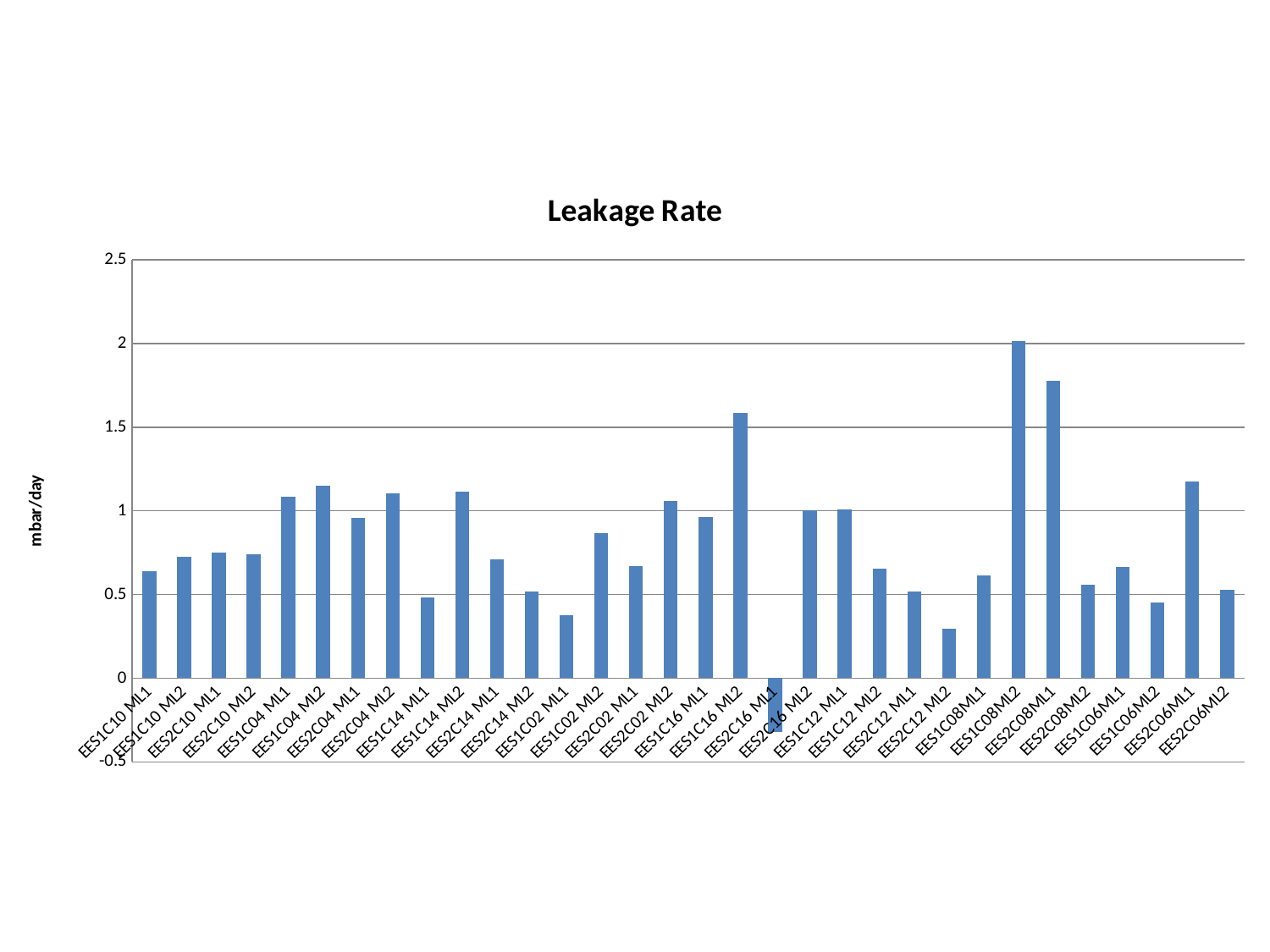
Which has the larger leakage rate, EES1C16 ML1 or EES1C16 ML2? EES1C16 ML2 Is the value for EES1C16 ML2 greater or less than 1.5? greater What type of chart is shown on the slide? bar chart Which category has the highest leakage rate? EES1C08ML2 Is the value for EES2C08ML1 greater or less than 1.5? greater Which category has the lowest leakage rate? EES2C16 ML1 How many categories (bars) are plotted in the chart? 32 Is the value for EES2C12 ML2 greater or less than 0.5? less Which has the larger leakage rate, EES1C08ML2 or EES2C08ML1? EES1C08ML2 What is the title of the chart? Leakage Rate What is the label on the vertical axis of the chart? mbar/day